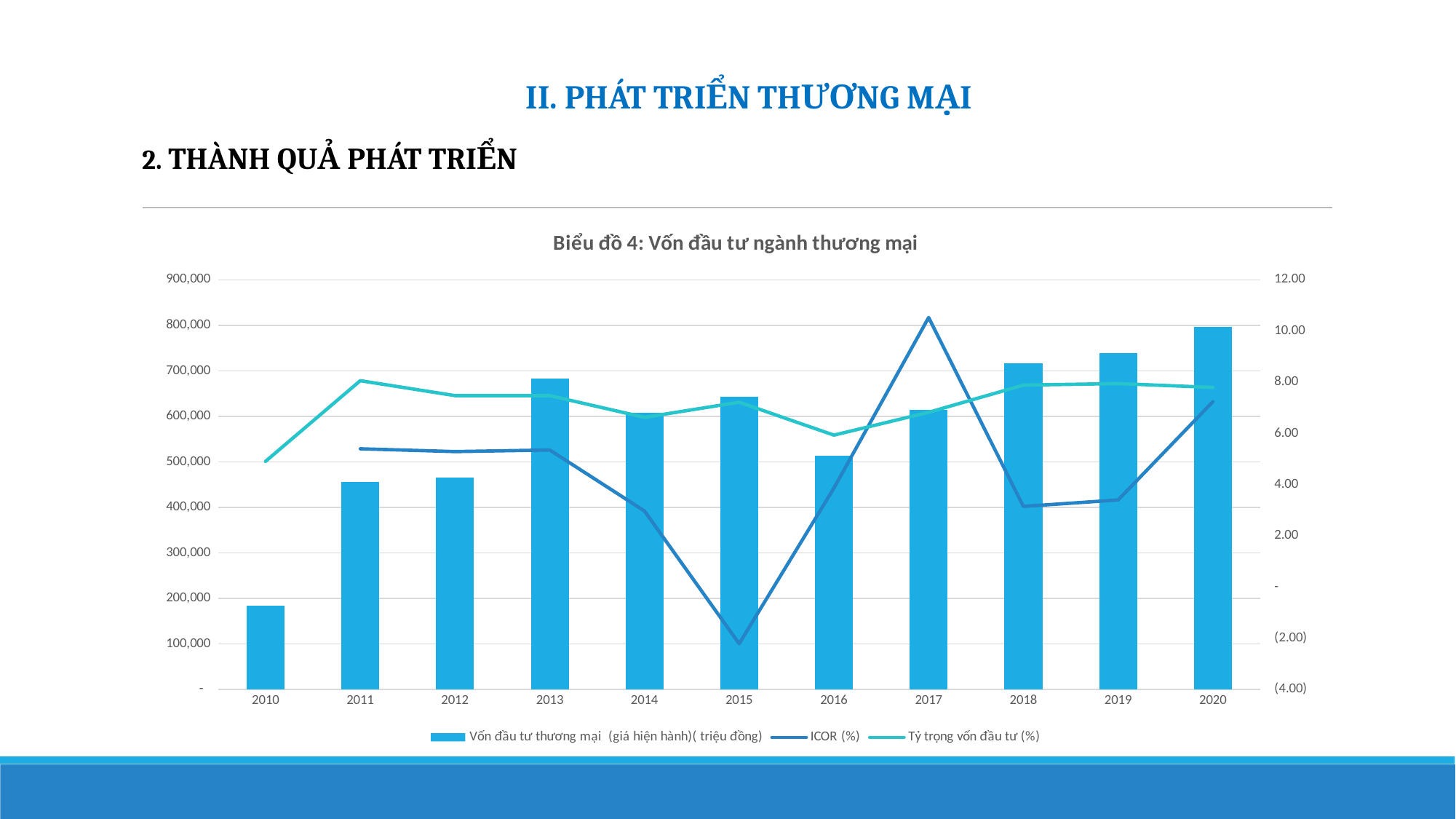
In which year does the ICOR (%) line reach its highest point? 2017 What kind of chart is Biểu đồ 4? Combined bar and line chart What is the title of the chart? Biểu đồ 4: Vốn đầu tư ngành thương mại In which year does the ICOR (%) line reach its lowest point? 2015 Which year has the tallest bar for Vốn đầu tư thương mại? 2020 How many series does the legend list? 3 Is the ICOR (%) value for 2015 greater or less than 2.00 on the right axis? less Is the Vốn đầu tư thương mại bar for 2010 greater or less than 200,000? less Which year has the shortest bar for Vốn đầu tư thương mại? 2010 How many years are shown on the x axis of the chart? 11 Is the Vốn đầu tư thương mại bar for 2020 greater or less than 700,000? greater Which year has the larger Vốn đầu tư thương mại bar, 2013 or 2014? 2013